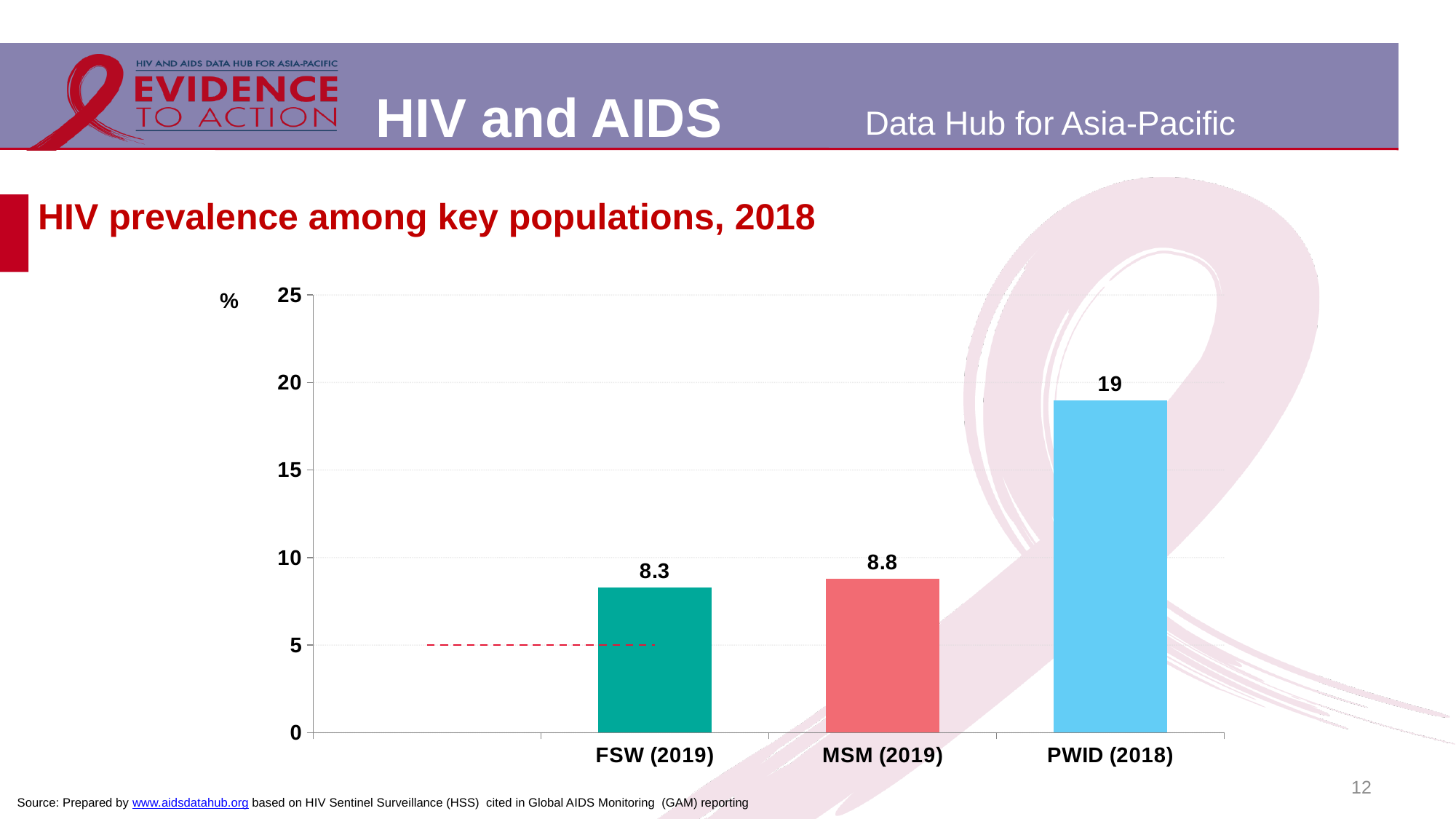
What kind of chart is shown on the slide? Bar chart What is the HIV prevalence value shown for MSM (2019)? 8.8 What is the HIV prevalence value shown for FSW (2019)? 8.3 What is the difference between the values for MSM (2019) and FSW (2019)? 0.5 What is the difference between the values for PWID (2018) and MSM (2019)? 10.2 Which key population has the lowest HIV prevalence on the chart? FSW (2019) What is the HIV prevalence value shown for PWID (2018)? 19 What is the title of the chart on the slide? HIV prevalence among key populations, 2018 How many key population categories are shown on the chart? 3 Which key population has the highest HIV prevalence on the chart? PWID (2018) Is the value for PWID (2018) greater or less than 15? greater Which is larger, the value for PWID (2018) or the value for FSW (2019)? PWID (2018)